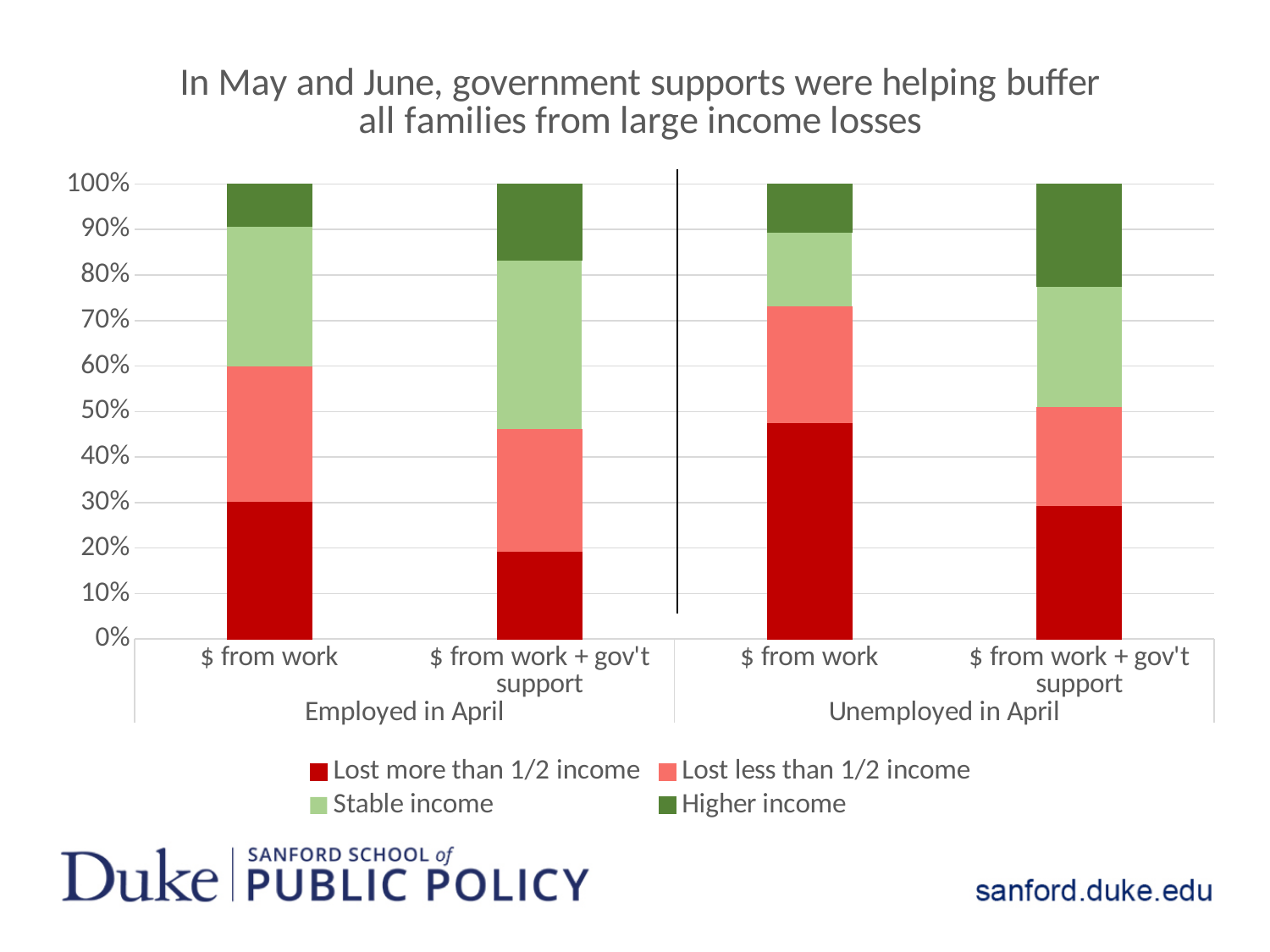
What is the total of the stacked bar for '$ from work' under 'Employed in April'? 100% Is the 'Lost more than 1/2 income' share for '$ from work' under 'Employed in April' greater or less than 40%? less Is the 'Lost more than 1/2 income' share for '$ from work' under 'Unemployed in April' greater or less than 40%? greater Is the 'Lost more than 1/2 income' share for '$ from work + gov't support' under 'Unemployed in April' greater or less than 40%? less Which bar has the larger 'Higher income' segment: '$ from work' under 'Employed in April' or '$ from work + gov't support' under 'Unemployed in April'? $ from work + gov't support under Unemployed in April Which bar has the largest 'Lost more than 1/2 income' segment? $ from work under Unemployed in April How many bars are plotted in the chart? 4 Which bar has the larger 'Lost more than 1/2 income' segment: '$ from work' under 'Employed in April' or '$ from work' under 'Unemployed in April'? $ from work under Unemployed in April What is the title of the chart? In May and June, government supports were helping buffer all families from large income losses How many series does the legend list? 4 What kind of chart is shown on the slide? Stacked bar chart